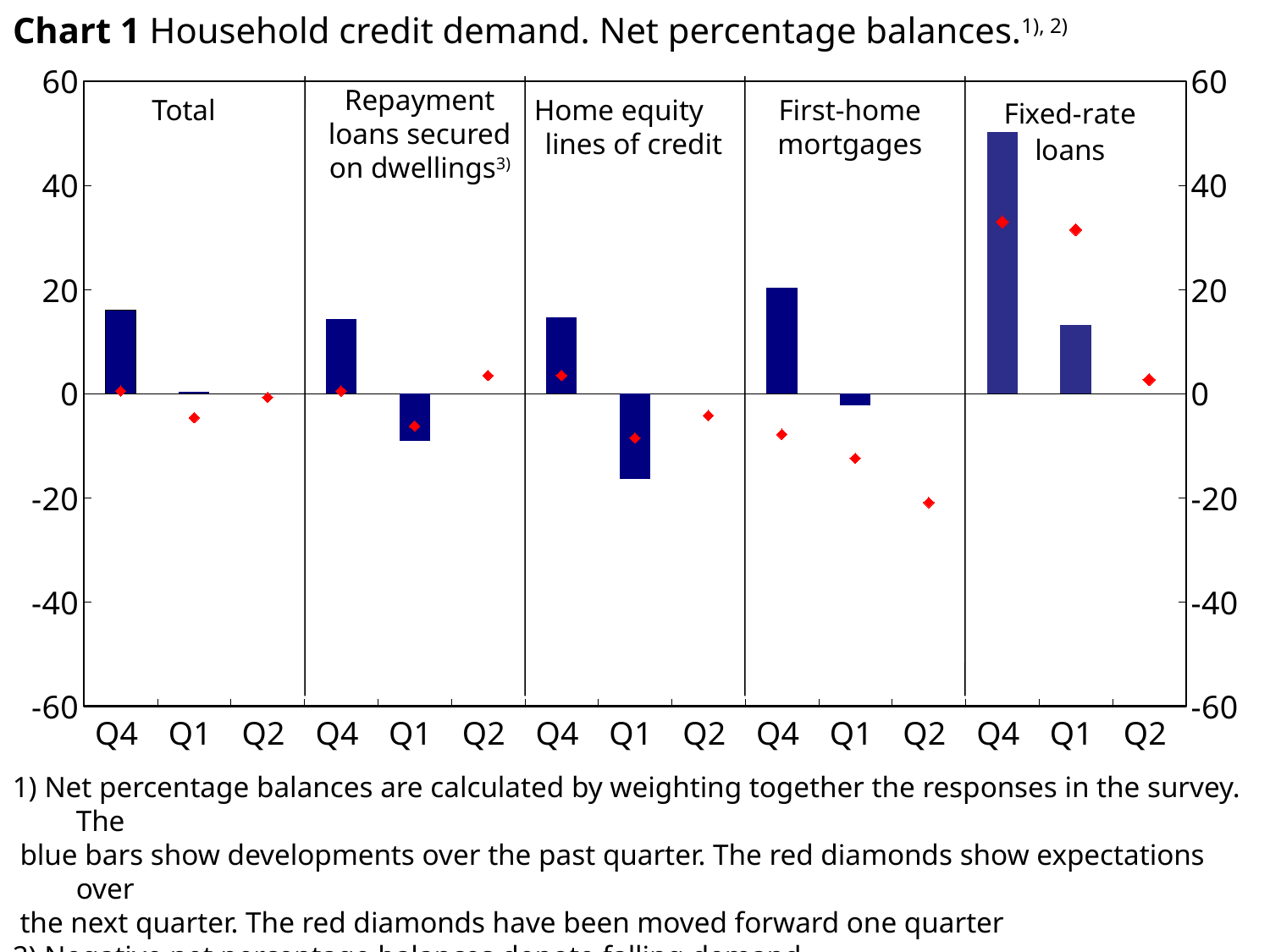
Which category has the highest Q4 bar? Fixed-rate loans Is the Q4 red diamond for Fixed-rate loans greater or less than 20? greater Is the Q1 bar for Home equity lines of credit greater or less than -10? less Which category has the lowest (most negative) Q1 bar? Home equity lines of credit What kind of chart is Chart 1? bar chart Is the Q2 red diamond for First-home mortgages greater or less than -10? less Which is larger: the Q4 bar for Total or the Q4 bar for First-home mortgages? First-home mortgages Do the bars for Fixed-rate loans rise or fall from Q4 to Q1? fall According to the footnote, what do the red diamonds show? Expectations over the next quarter How many loan categories (panels) are shown in the chart? 5